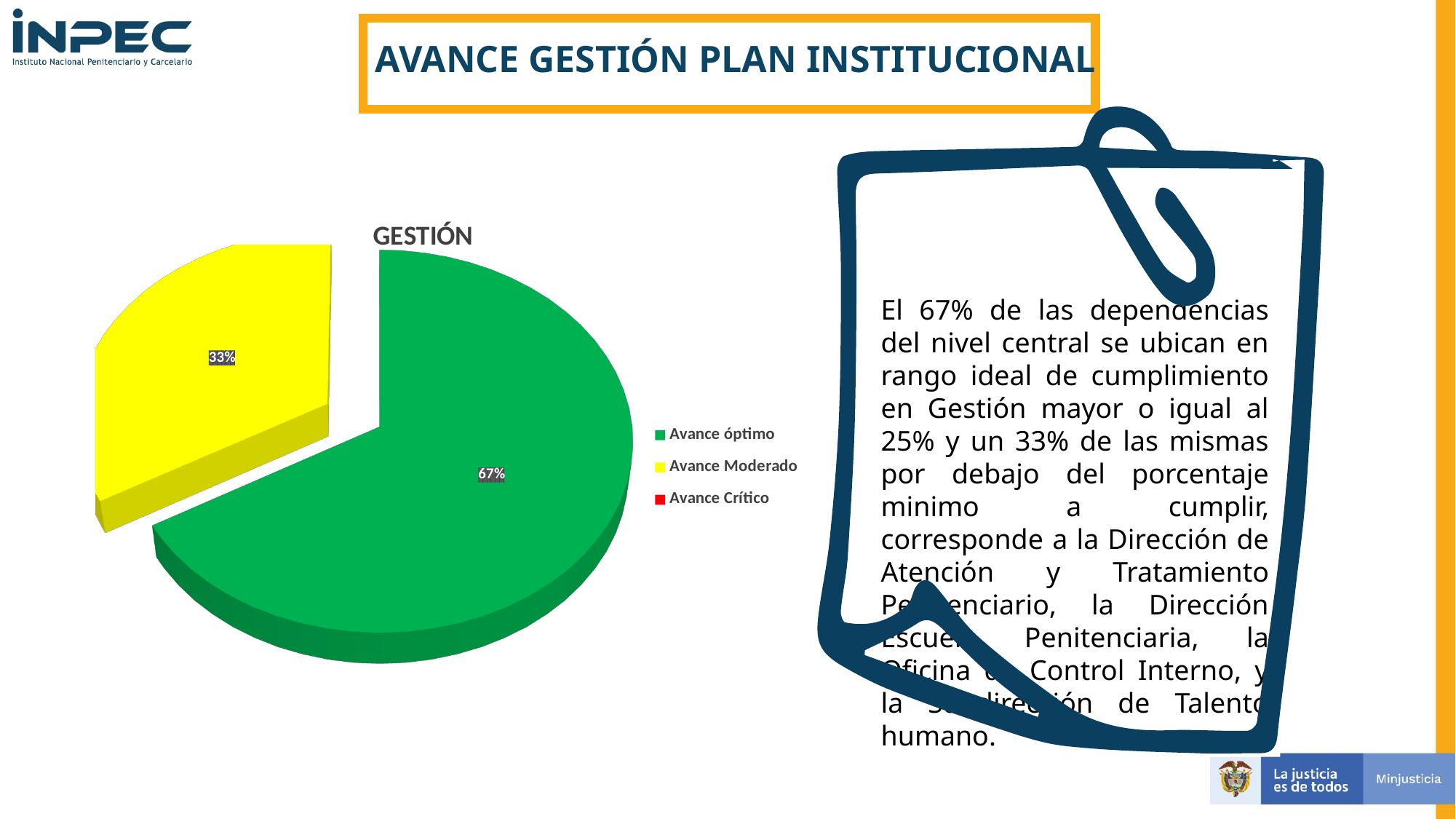
What kind of chart is shown on the slide? Pie chart What is the difference in percentage points between the Avance óptimo and Avance Moderado slices? 34 What percentage does the Avance óptimo slice show? 67% How many slices with data labels are visible in the pie chart? 2 What percentage does the Avance Moderado slice show? 33% How many entries does the legend list? 3 Which of the two labelled slices is larger, Avance óptimo or Avance Moderado? Avance óptimo What is the combined share of the Avance óptimo and Avance Moderado slices? 100% What colour represents Avance Moderado in the chart? Yellow What is the title of the chart? GESTIÓN Which category has the largest share of the pie? Avance óptimo